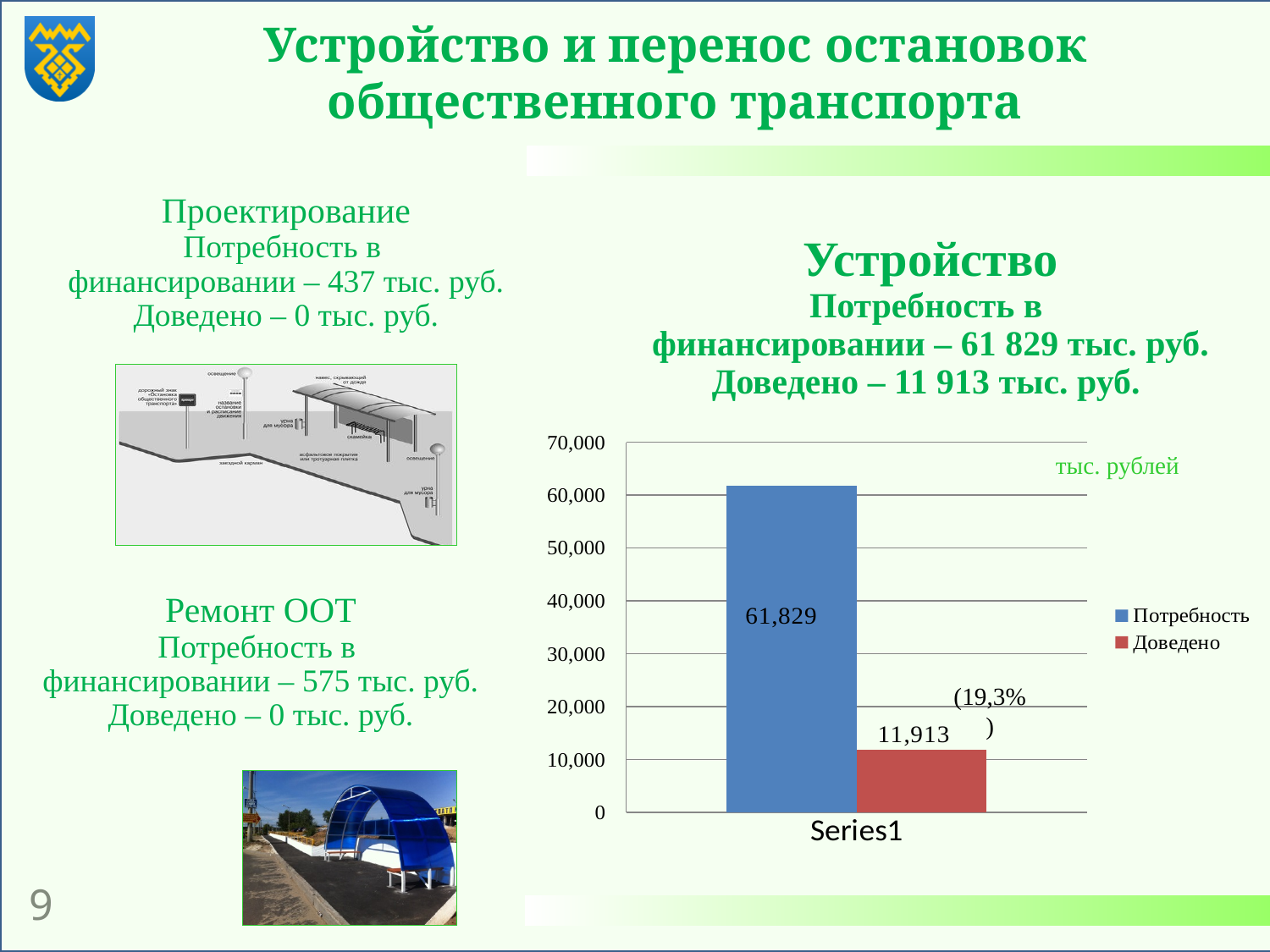
What is the value of the Доведено bar in the chart? 11,913 Is the value of the Потребность bar greater or less than 60,000? greater What is the category label shown on the x axis of the chart? Series1 What type of chart is shown on the slide? bar chart What percentage is printed next to the Доведено bar in the chart? 19,3% What is the difference between the Потребность and Доведено values in the chart? 49,916 What is the value of the Потребность bar in the chart? 61,829 What unit label is printed in the upper right of the chart's plot area? тыс. рублей How many series does the chart legend list? 2 Which series has the lowest value in the chart? Доведено Which series has the higher value in the chart, Потребность or Доведено? Потребность Is the value of the Доведено bar greater or less than 20,000? less